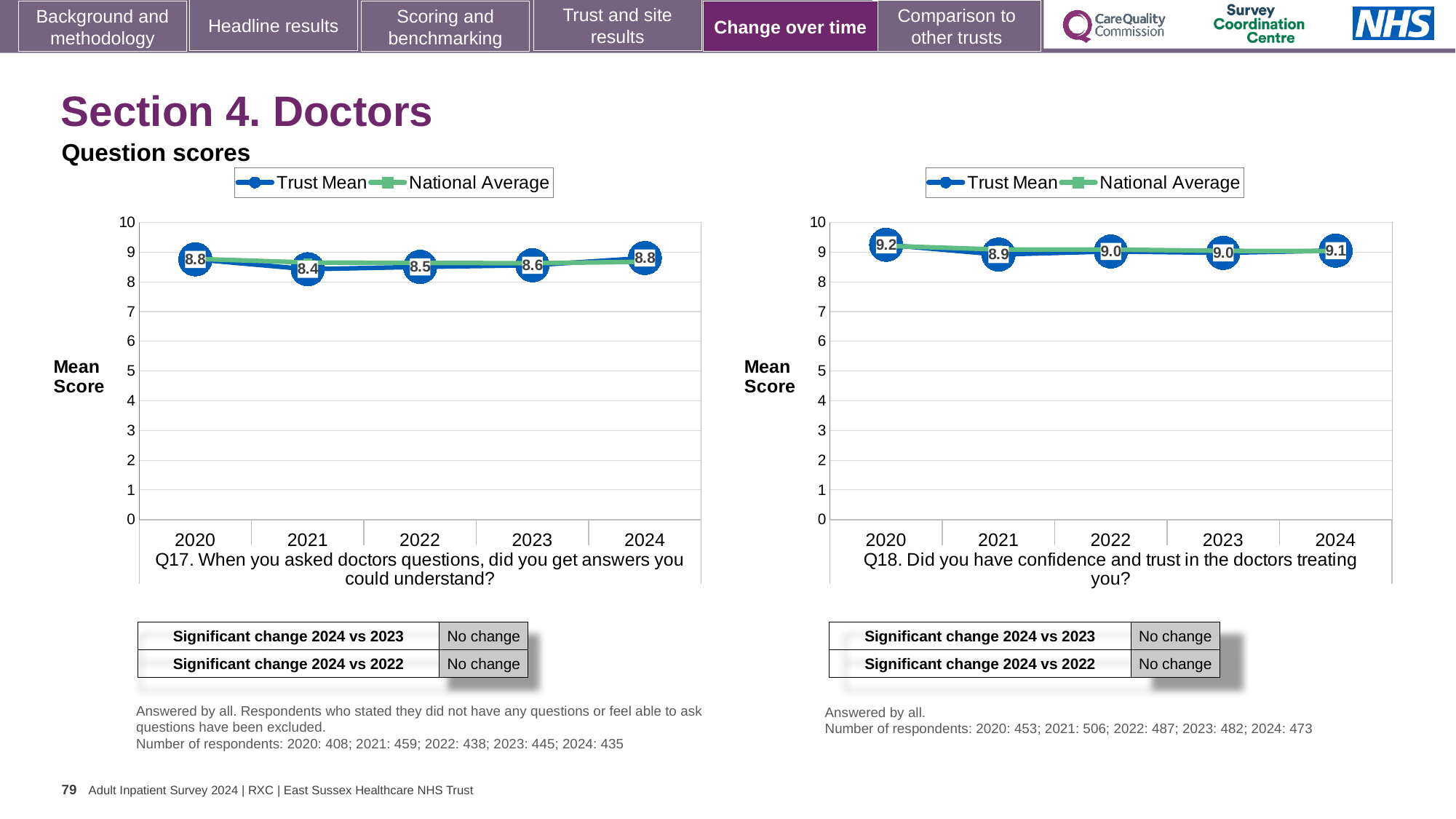
In the Q18 chart, which year has the lowest Trust Mean score? 2021 In the Q17 chart, what is the difference between the Trust Mean scores for 2024 and 2021? 0.4 How many years are shown on the x axis of the Q18 chart? 5 How many series does the legend of the Q17 chart list? 2 In the Q17 chart, what is the Trust Mean score for 2021? 8.4 In the Q17 chart, which year has the lowest Trust Mean score? 2021 In the Q18 chart, which year has the highest Trust Mean score? 2020 In the Q18 chart, what is the Trust Mean score for 2020? 9.2 In the Q18 chart, what is the difference between the Trust Mean scores for 2020 and 2021? 0.3 What kind of chart is used for Q18? Line chart In the Q17 chart, is the National Average value for 2021 greater or less than 8? greater In the Q17 chart, is the Trust Mean score higher in 2022 or in 2023? 2023